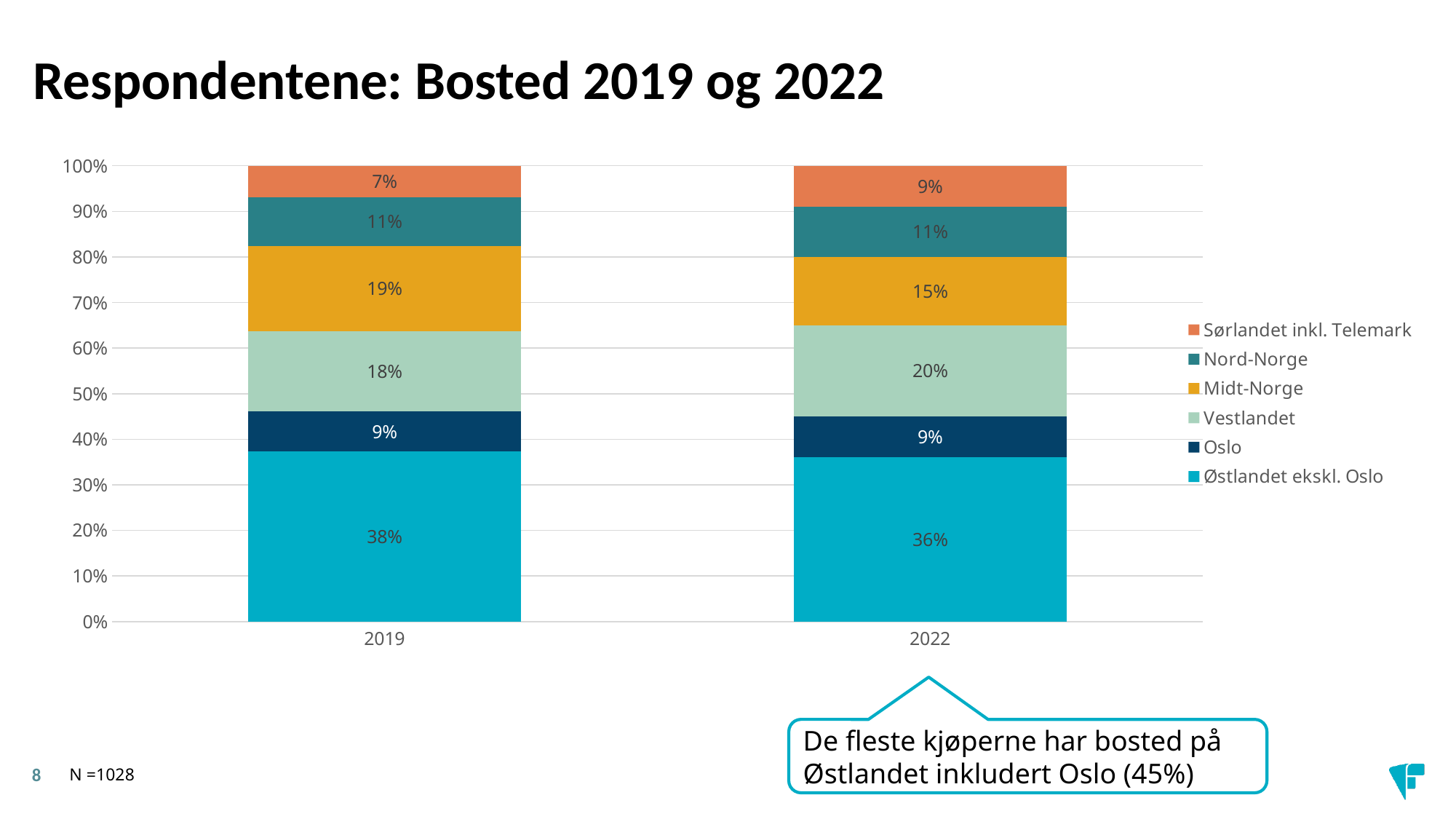
What is the title of the slide? Respondentene: Bosted 2019 og 2022 By how many percentage points did the share for Midt-Norge change from 2019 to 2022? 4 percentage points Was the share for Vestlandet larger in 2019 or in 2022? 2022 How many series does the legend list? 6 What kind of chart is shown on the slide? Stacked bar chart What percentage of respondents lived in Midt-Norge in 2022? 15% What percentage of respondents lived in Sørlandet inkl. Telemark in 2022? 9% What percentage of respondents lived in Vestlandet in 2019? 18% Which region had the smallest share of respondents in 2019? Sørlandet inkl. Telemark Which region had the largest share of respondents in 2022? Østlandet ekskl. Oslo What percentage of respondents lived in Østlandet ekskl. Oslo in 2019? 38% How many years are shown on the x axis? 2